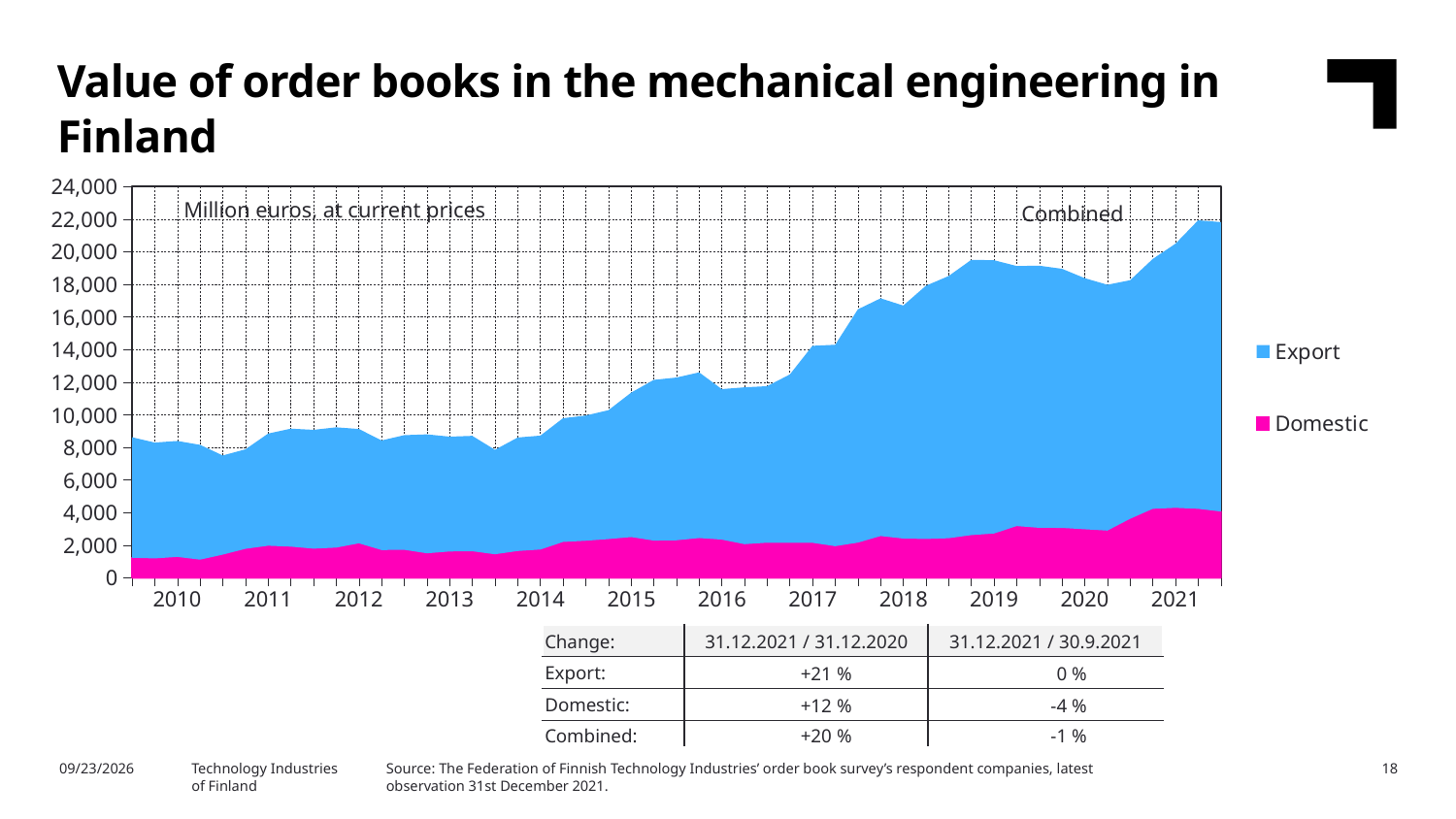
What kind of chart is shown on the slide? Stacked area chart Which series is larger in 2021, Export or Domestic? Export How many years are labelled on the x axis of the chart? 12 Is the combined value of order books in 2019 greater or less than 18,000? greater Overall, does the combined value of order books rise or fall from 2010 to 2021? rise How many series does the chart legend list? 2 Is the combined value of order books at the start of 2010 greater or less than 10,000? less Which two series are listed in the chart legend? Export and Domestic In which year does the combined value of order books reach its highest level? 2021 Is the combined value of order books at the end of 2021 greater or less than 20,000? greater What unit is the chart measured in, according to the label inside the plot area? Million euros, at current prices